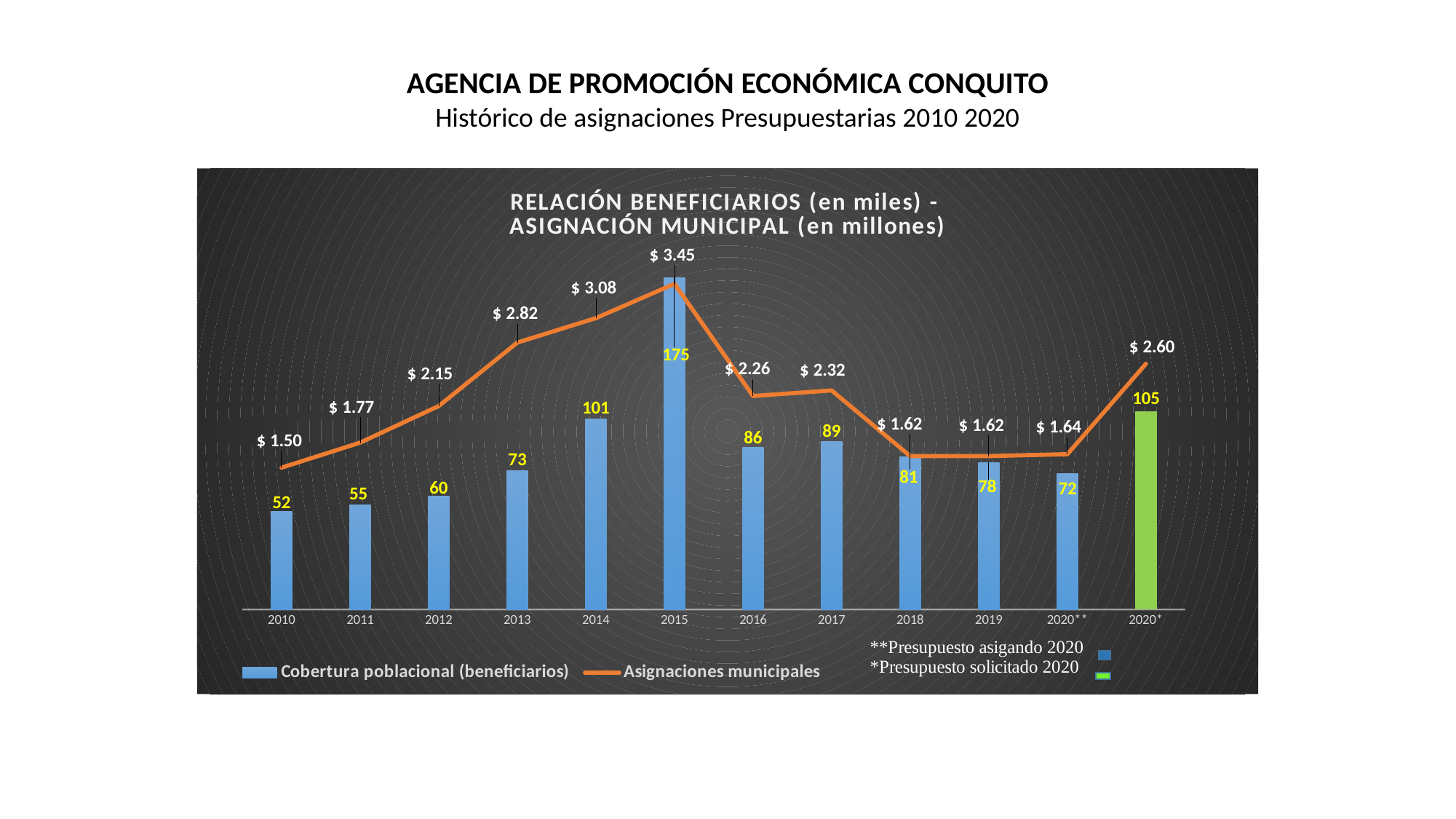
What is the value of Asignaciones municipales for 2020**? $ 1.64 How many categories are shown on the x axis? 12 Which year has the lowest value for Asignaciones municipales? 2010 What is the difference between the Cobertura poblacional values for 2014 and 2013? 28 Does the Asignaciones municipales line rise or fall from 2010 to 2015? Rise What is the value of Asignaciones municipales for 2013? $ 2.82 What is the value of Cobertura poblacional (beneficiarios) for 2015? 175 Which year has the highest value for Cobertura poblacional (beneficiarios)? 2015 What is the value of Cobertura poblacional (beneficiarios) for 2020*? 105 What kind of chart is this? Combined bar and line chart How many series does the legend list? 2 Which is larger, the Asignaciones municipales value for 2016 or for 2017? 2017